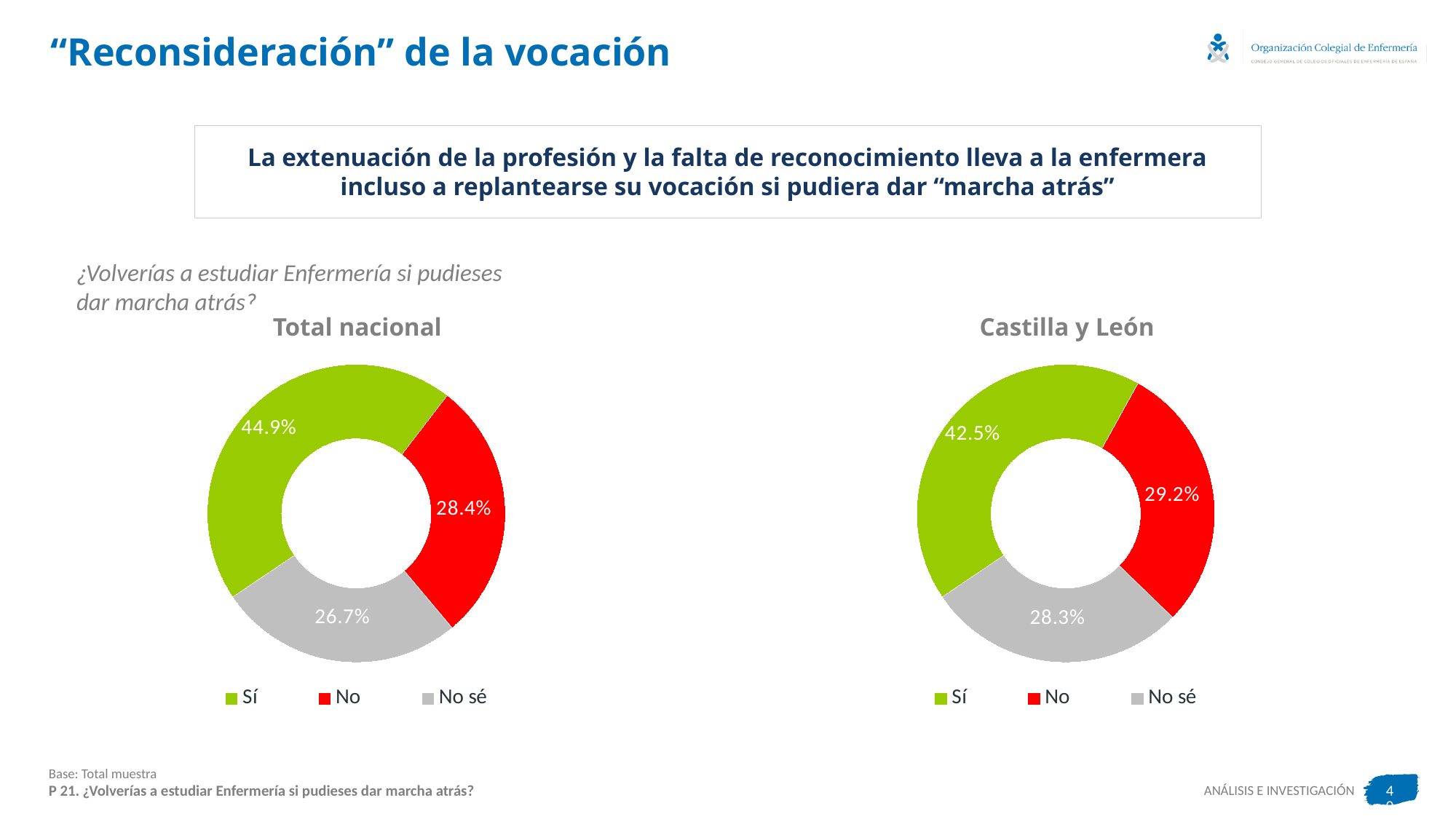
What kind of chart is the "Total nacional" chart? Doughnut chart How many categories does the "Castilla y León" chart show? 3 In the "Total nacional" chart, which category has the smallest share? No sé Is the "Sí" value larger in the "Total nacional" chart or in the "Castilla y León" chart? Total nacional In the "Total nacional" chart, what is the value for "No"? 28.4% In the "Total nacional" chart, which category has the largest share? Sí In the "Castilla y León" chart, which category has the largest share? Sí In the "Castilla y León" chart, what is the value for "Sí"? 42.5% In the "Total nacional" chart, what is the difference between the "Sí" and "No" values? 16.5% In the "Total nacional" chart, what is the value for "Sí"? 44.9% In the "Castilla y León" chart, which colour represents "No"? Red In the "Castilla y León" chart, what is the value for "No sé"? 28.3%